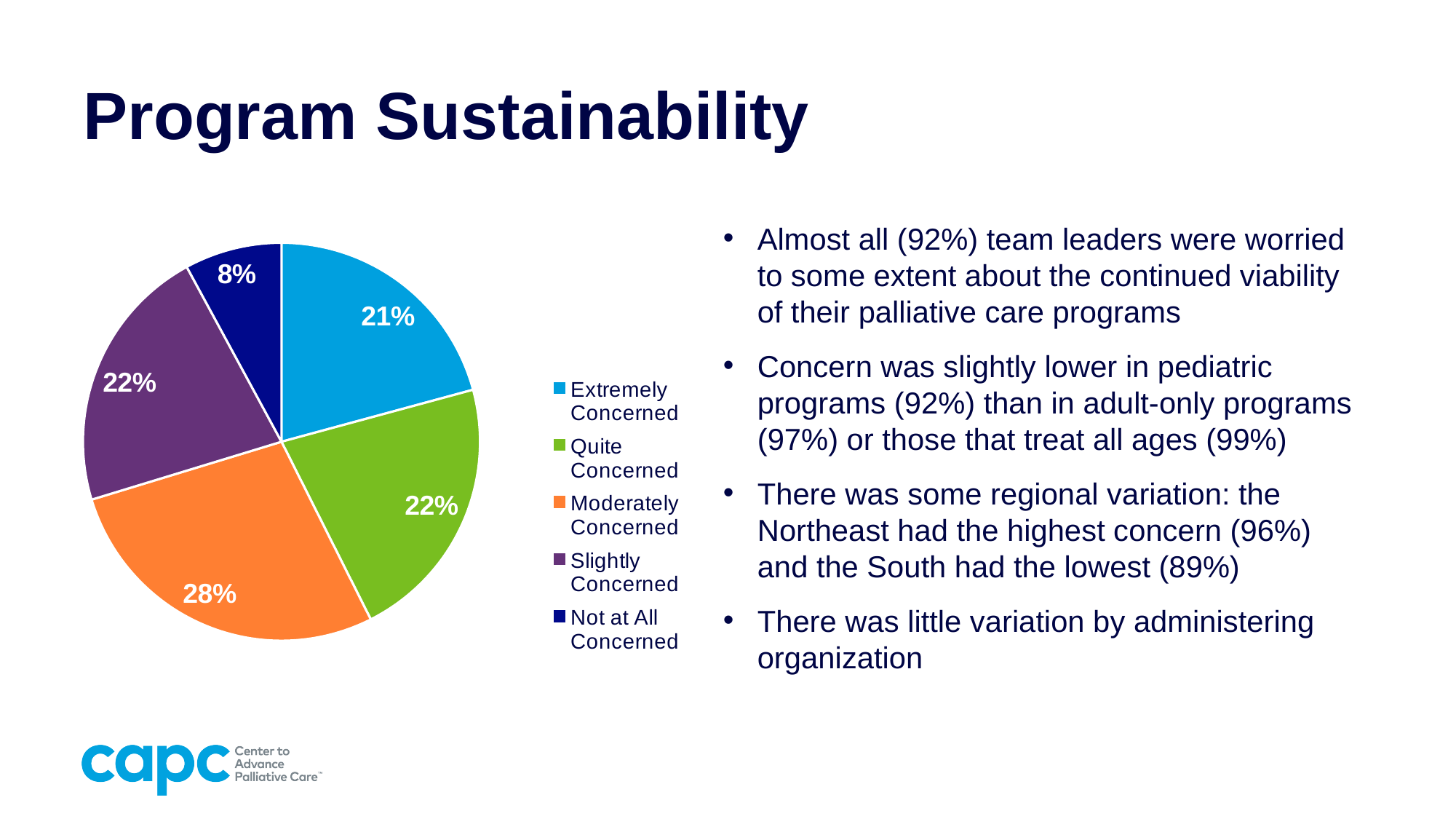
What is the combined share of the Extremely Concerned and Quite Concerned slices? 43% What is the difference between the Moderately Concerned and Not at All Concerned shares? 20% What share of the pie is labelled Extremely Concerned? 21% What share of the pie is labelled Moderately Concerned? 28% What kind of chart is shown on the slide? Pie chart Which category has the largest slice of the pie? Moderately Concerned Which is larger, the Moderately Concerned slice or the Extremely Concerned slice? Moderately Concerned Which category has the smallest slice of the pie? Not at All Concerned What colour is the Quite Concerned slice in the pie chart? Green How many categories does the pie chart have? 5 What share of the pie is labelled Not at All Concerned? 8%